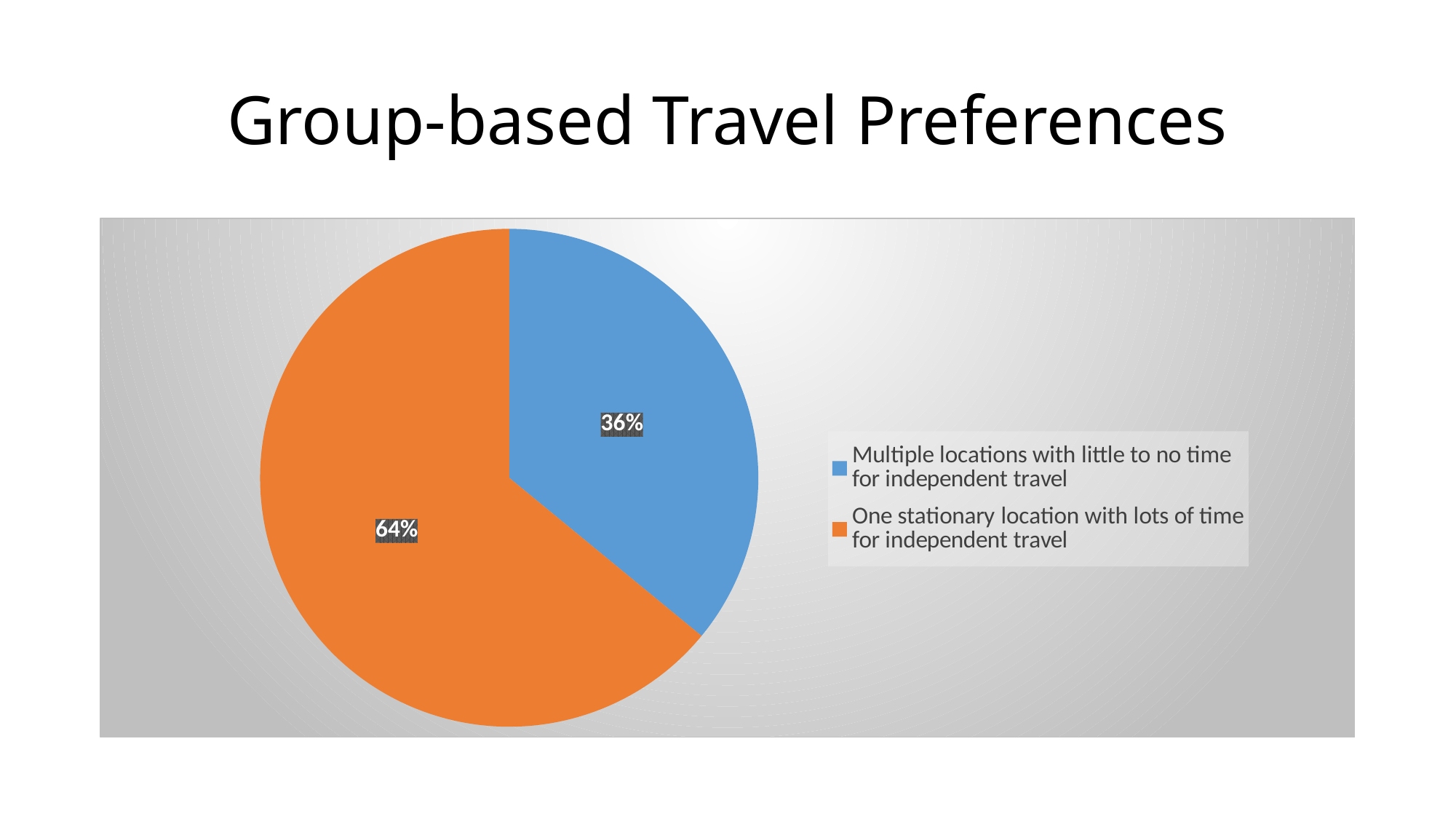
What is the difference in percentage points between the two slices? 28 How many slices does the pie chart have? 2 What share of the pie is 'One stationary location with lots of time for independent travel'? 64% How many entries does the legend list? 2 What share of the pie is 'Multiple locations with little to no time for independent travel'? 36% Which category has the smallest slice of the pie? Multiple locations with little to no time for independent travel What colour is the slice for 'One stationary location with lots of time for independent travel'? orange Which category has the largest slice of the pie? One stationary location with lots of time for independent travel What type of chart is shown on the slide? pie chart Which is larger: the slice for 'Multiple locations with little to no time for independent travel' or the slice for 'One stationary location with lots of time for independent travel'? One stationary location with lots of time for independent travel What is the title of the slide? Group-based Travel Preferences